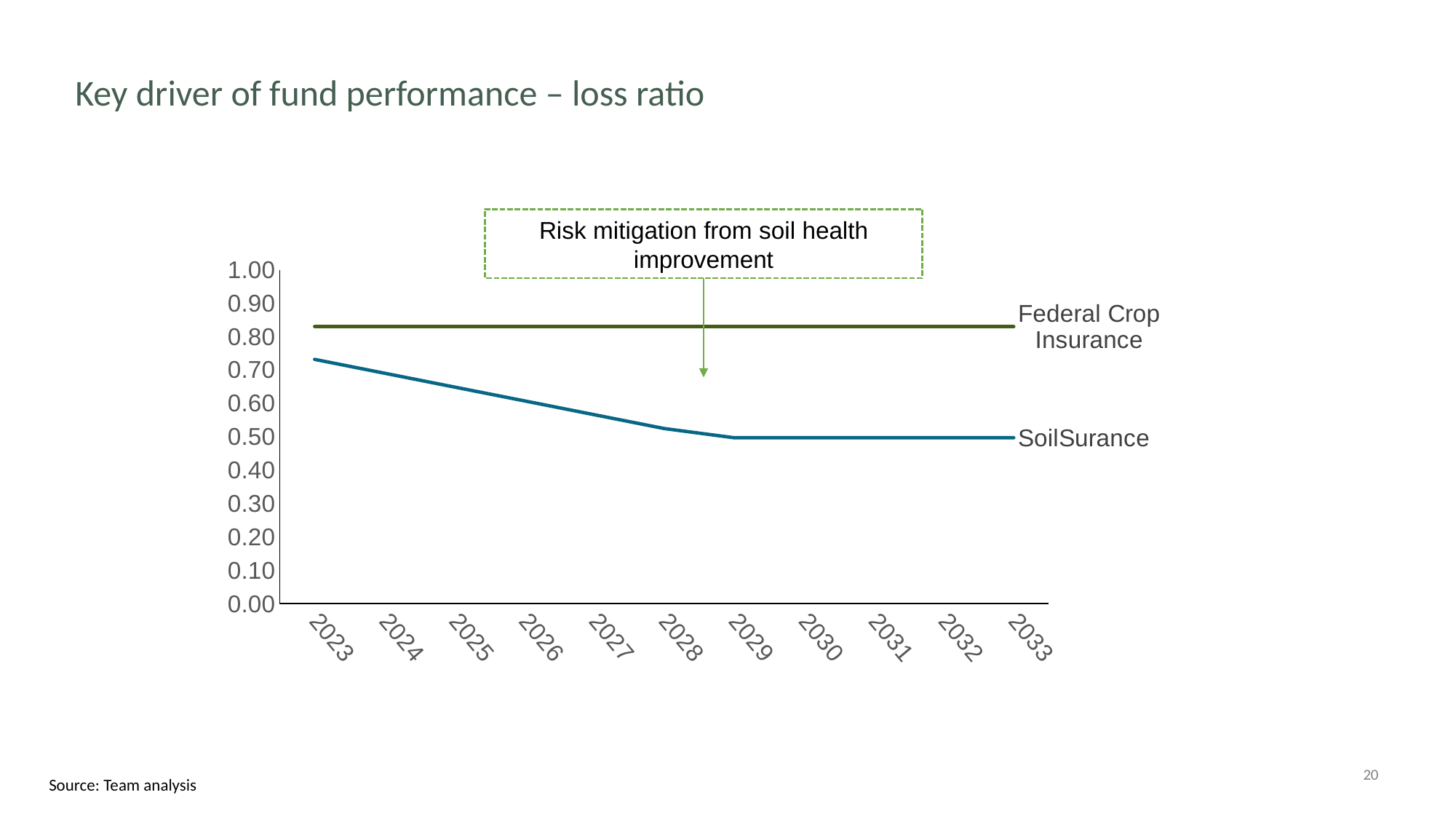
Which series has the higher value in 2023, Federal Crop Insurance or SoilSurance? Federal Crop Insurance Does the SoilSurance line rise or fall between 2023 and 2029? fall What kind of chart is shown on the slide? line chart What does the dashed annotation box above the chart say? Risk mitigation from soil health improvement Is the value for SoilSurance in 2025 greater or less than 0.60? greater How many years are shown on the x axis? 11 Is the value for SoilSurance in 2027 greater or less than 0.60? less What is the title of the slide? Key driver of fund performance – loss ratio Is the value for Federal Crop Insurance in 2025 greater or less than 0.80? greater How many series does the chart show? 2